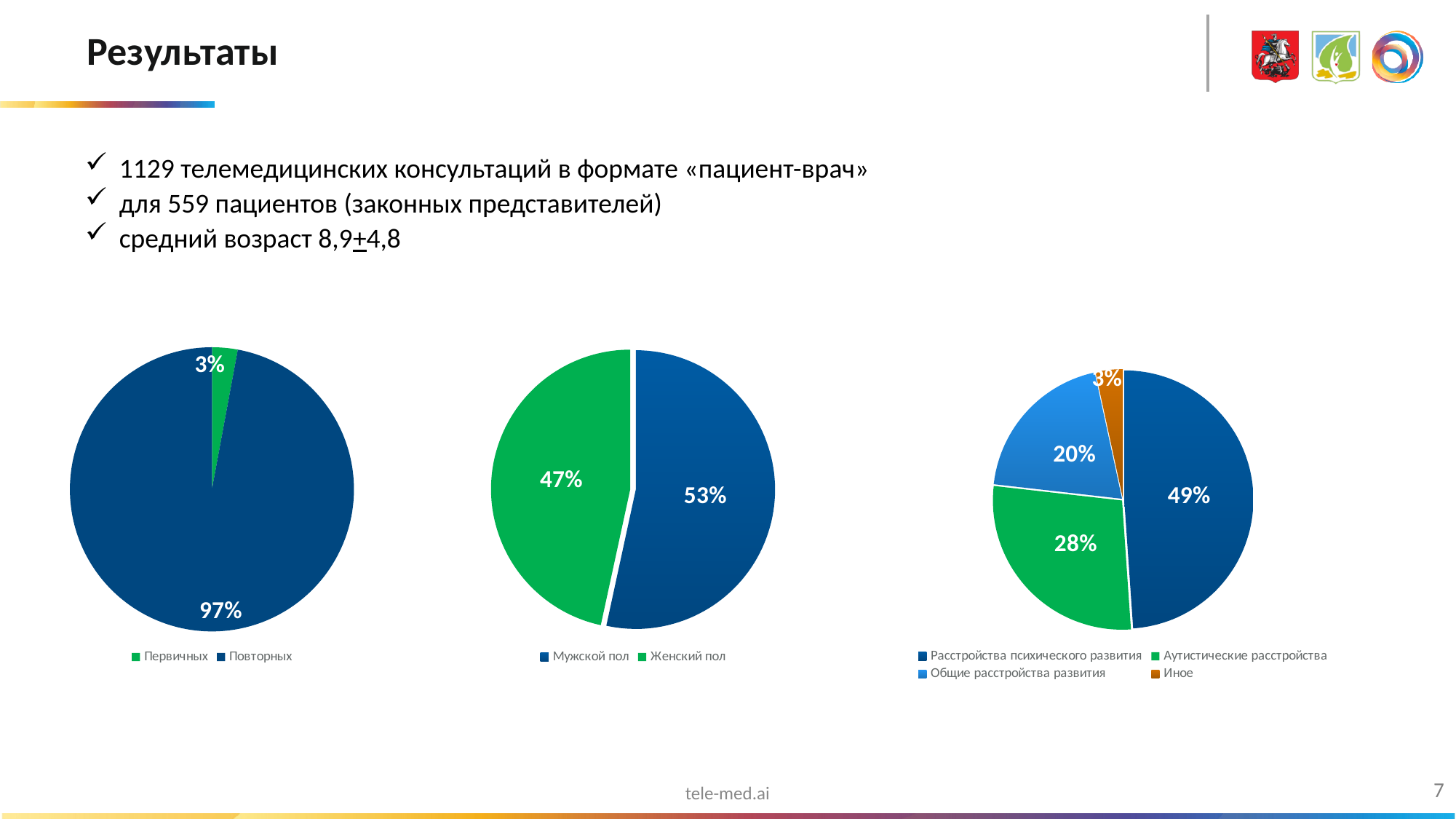
In the right pie chart, what share is labelled for Аутистические расстройства? 28% In the right pie chart, what is the difference between the shares for Расстройства психического развития and Аутистические расстройства? 21% In the middle pie chart, what is the difference between the shares for Мужской пол and Женский пол? 6% In the middle pie chart, what share is labelled for Мужской пол? 53% In the left pie chart, what share is labelled for Повторных? 97% In the right pie chart, what share is labelled for Общие расстройства развития? 20% In the middle pie chart, which category has the larger share, Мужской пол or Женский пол? Мужской пол What type of chart is the middle chart on the slide? Pie chart In the left pie chart, what share is labelled for Первичных? 3% In the right pie chart, which category has the largest share? Расстройства психического развития How many categories does the legend of the right pie chart list? 4 In the right pie chart, which category has the smallest share? Иное